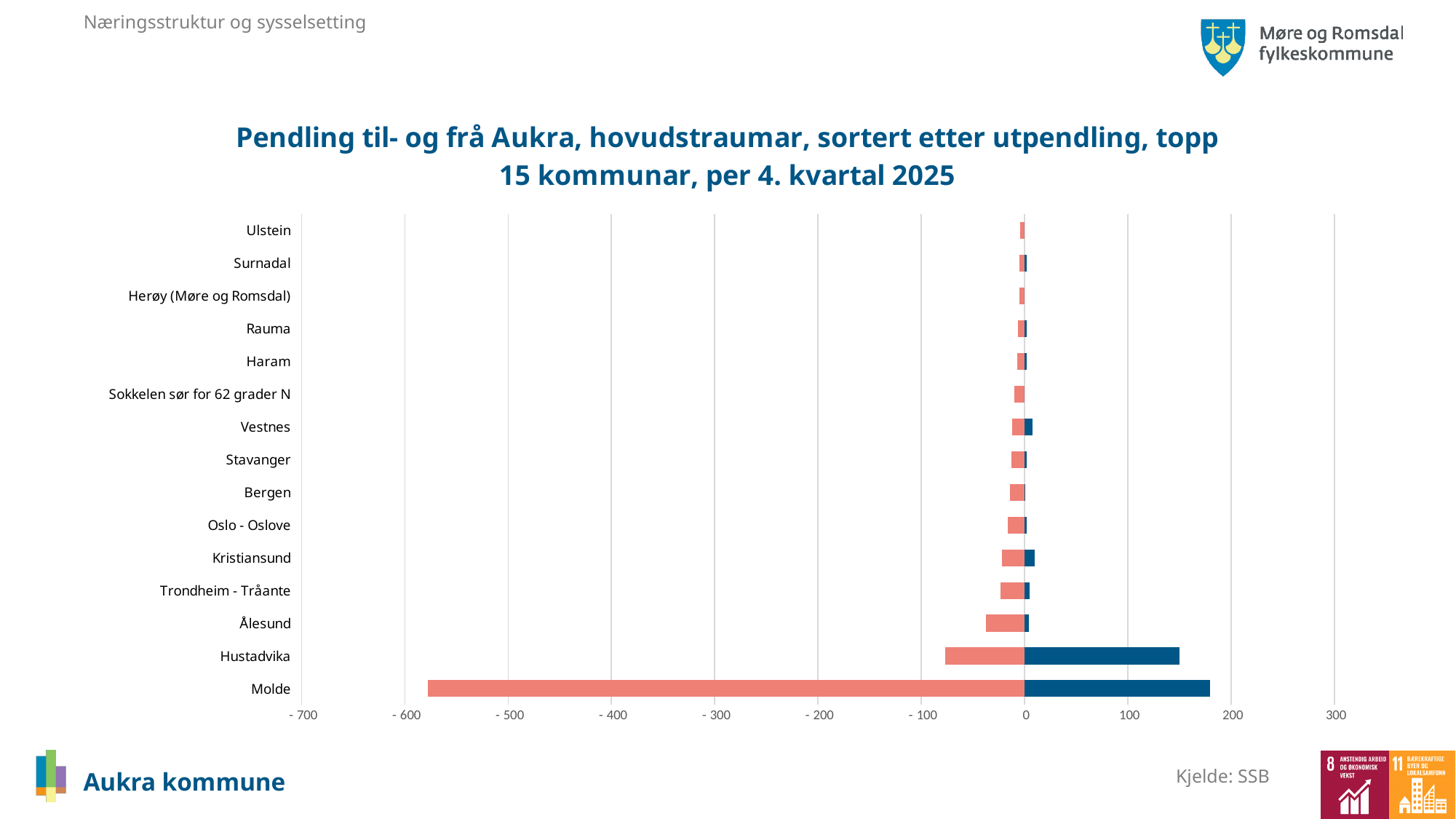
Which has the longer blue bar, Molde or Hustadvika? Molde Is the blue bar for Hustadvika greater or less than 100? greater Is the blue bar for Molde greater or less than 100? greater What is the title of the chart? Pendling til- og frå Aukra, hovudstraumar, sortert etter utpendling, topp 15 kommunar, per 4. kvartal 2025 Is the red bar for Molde greater or less than -500? less Which municipality has the longest blue (positive) bar in the chart? Molde Which has the longer red bar, Ålesund or Ulstein? Ålesund How many municipalities (categories) are listed on the vertical axis of the chart? 15 What source is cited for the chart data? SSB Which municipality has the longest red (negative) bar in the chart? Molde What kind of chart is shown on the slide? bar chart